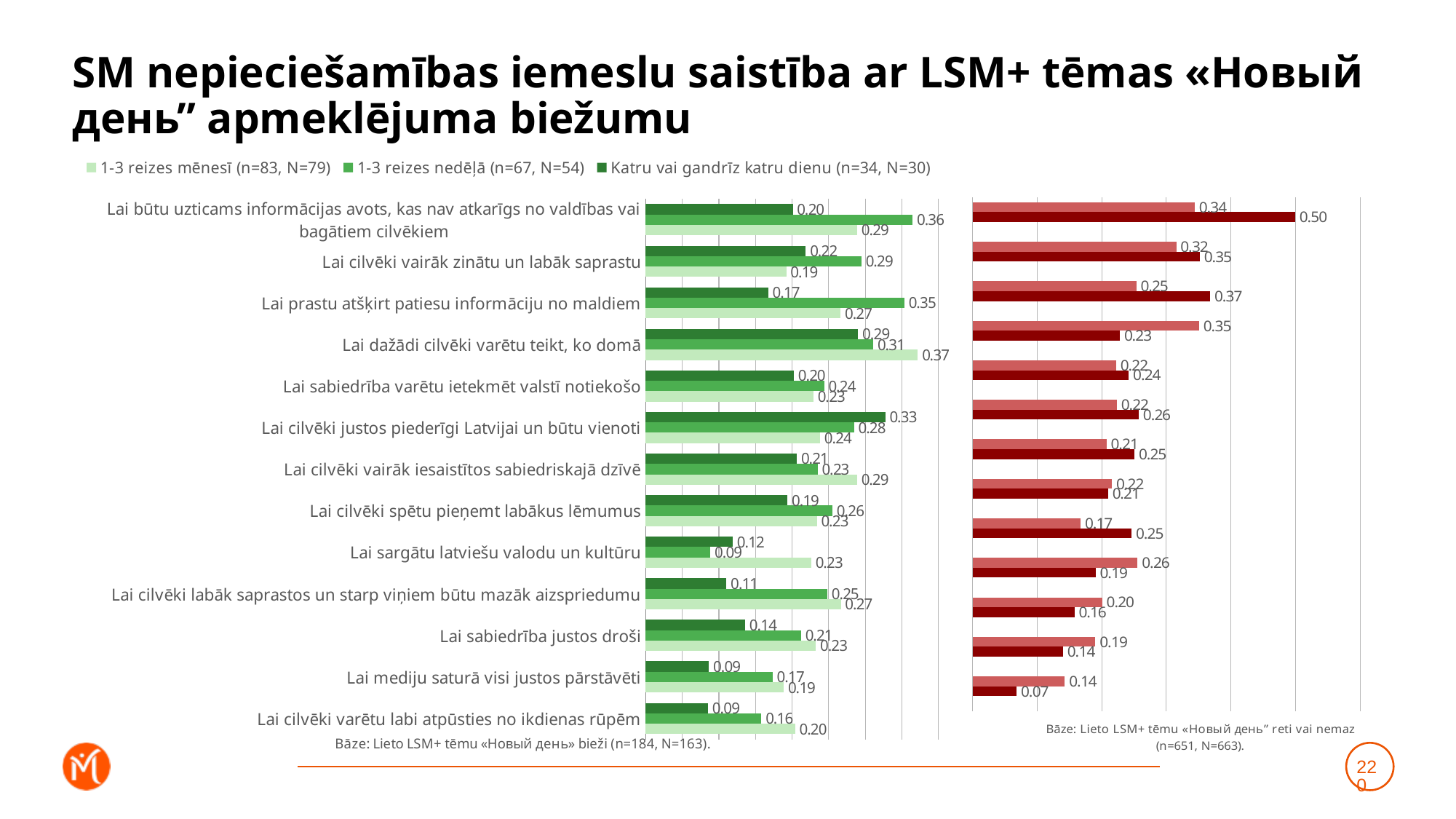
On the left (green) chart, for 'Lai sabiedrība justos droši', which is larger: the '1-3 reizes mēnesī' value or the 'Katru vai gandrīz katru dienu' value? 1-3 reizes mēnesī On the right (red) chart, what is the value of the dark red bar for 'Lai cilvēki varētu labi atpūsties no ikdienas rūpēm'? 0.07 On the left (green) chart, what is the value for 'Katru vai gandrīz katru dienu' for 'Lai cilvēki justos piederīgi Latvijai un būtu vienoti'? 0.33 How many categories are shown on the left (green) chart? 13 What kind of chart is used on this slide? Bar chart On the left (green) chart, which category has the highest value for '1-3 reizes nedēļā'? Lai būtu uzticams informācijas avots, kas nav atkarīgs no valdības vai bagātiem cilvēkiem On the left (green) chart, which category has the lowest value for '1-3 reizes nedēļā'? Lai sargātu latviešu valodu un kultūru How many series does the legend of the left (green) chart list? 3 On the left (green) chart, what is the difference between the '1-3 reizes nedēļā' and 'Katru vai gandrīz katru dienu' values for 'Lai būtu uzticams informācijas avots, kas nav atkarīgs no valdības vai bagātiem cilvēkiem'? 0.16 On the left (green) chart, what is the value for '1-3 reizes mēnesī' for 'Lai dažādi cilvēki varētu teikt, ko domā'? 0.37 On the left (green) chart, what is the value for '1-3 reizes nedēļā' for 'Lai prastu atšķirt patiesu informāciju no maldiem'? 0.35 On the right (red) chart, what is the value of the dark red bar for 'Lai būtu uzticams informācijas avots, kas nav atkarīgs no valdības vai bagātiem cilvēkiem'? 0.50